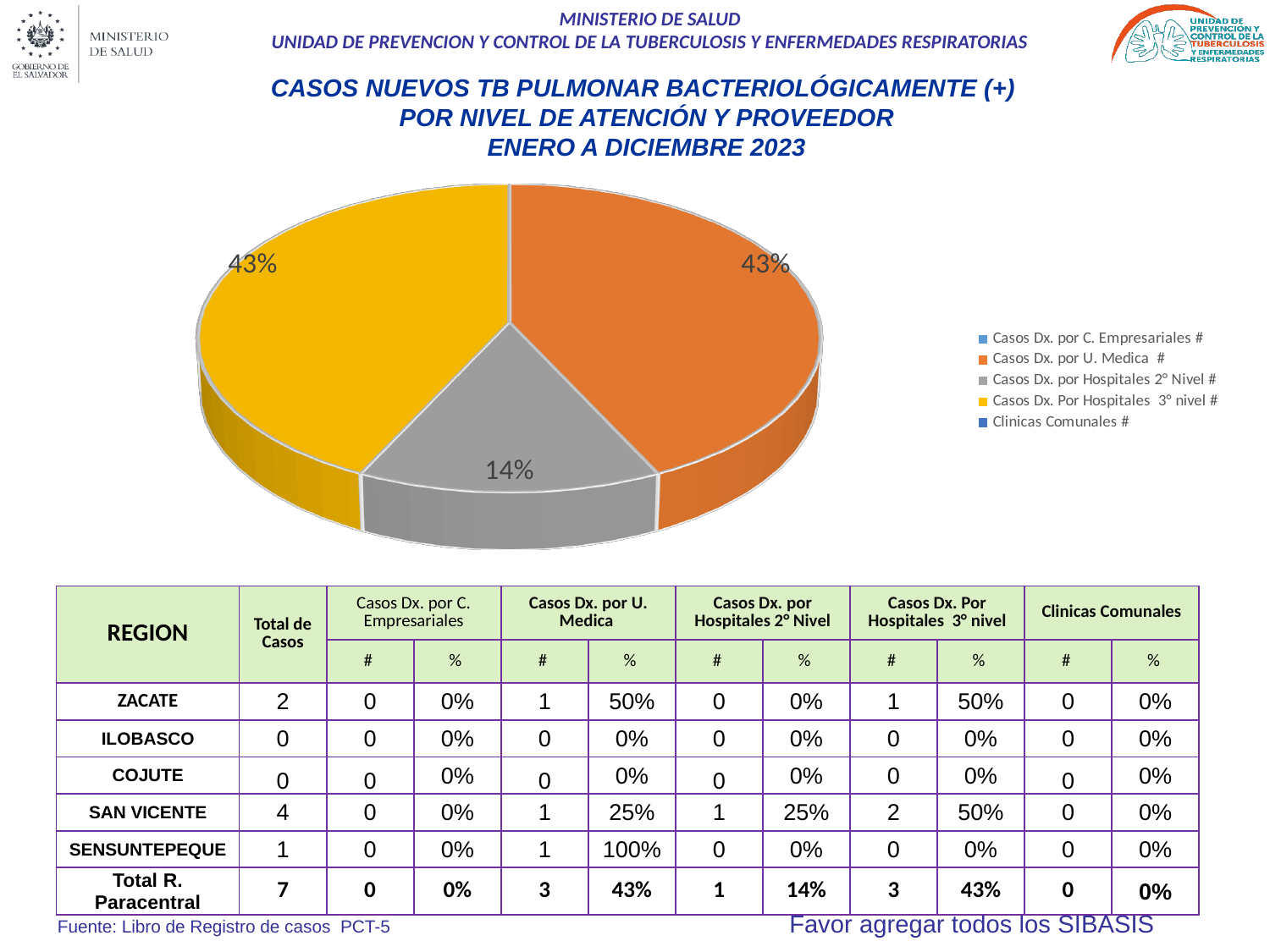
Which slice is larger: 'Casos Dx. por U. Medica' or 'Casos Dx. por Hospitales 2° Nivel'? Casos Dx. por U. Medica What colour is the 'Casos Dx. por Hospitales 2° Nivel' slice in the pie chart? Gray What kind of chart is shown on the slide? Pie chart What share of the pie does the 'Casos Dx. Por Hospitales 3° nivel' slice represent? 43% How many entries does the legend of the pie chart list? 5 How many slices with a percentage label are visible in the pie chart? 3 What colour is the 'Casos Dx. Por Hospitales 3° nivel' slice in the pie chart? Yellow Which category has the smallest visible slice in the pie chart? Casos Dx. por Hospitales 2° Nivel What share of the pie does the 'Casos Dx. por U. Medica' slice represent? 43% What share of the pie does the 'Casos Dx. por Hospitales 2° Nivel' slice represent? 14% What is the difference in percentage points between the 'Casos Dx. Por Hospitales 3° nivel' slice and the 'Casos Dx. por Hospitales 2° Nivel' slice? 29%